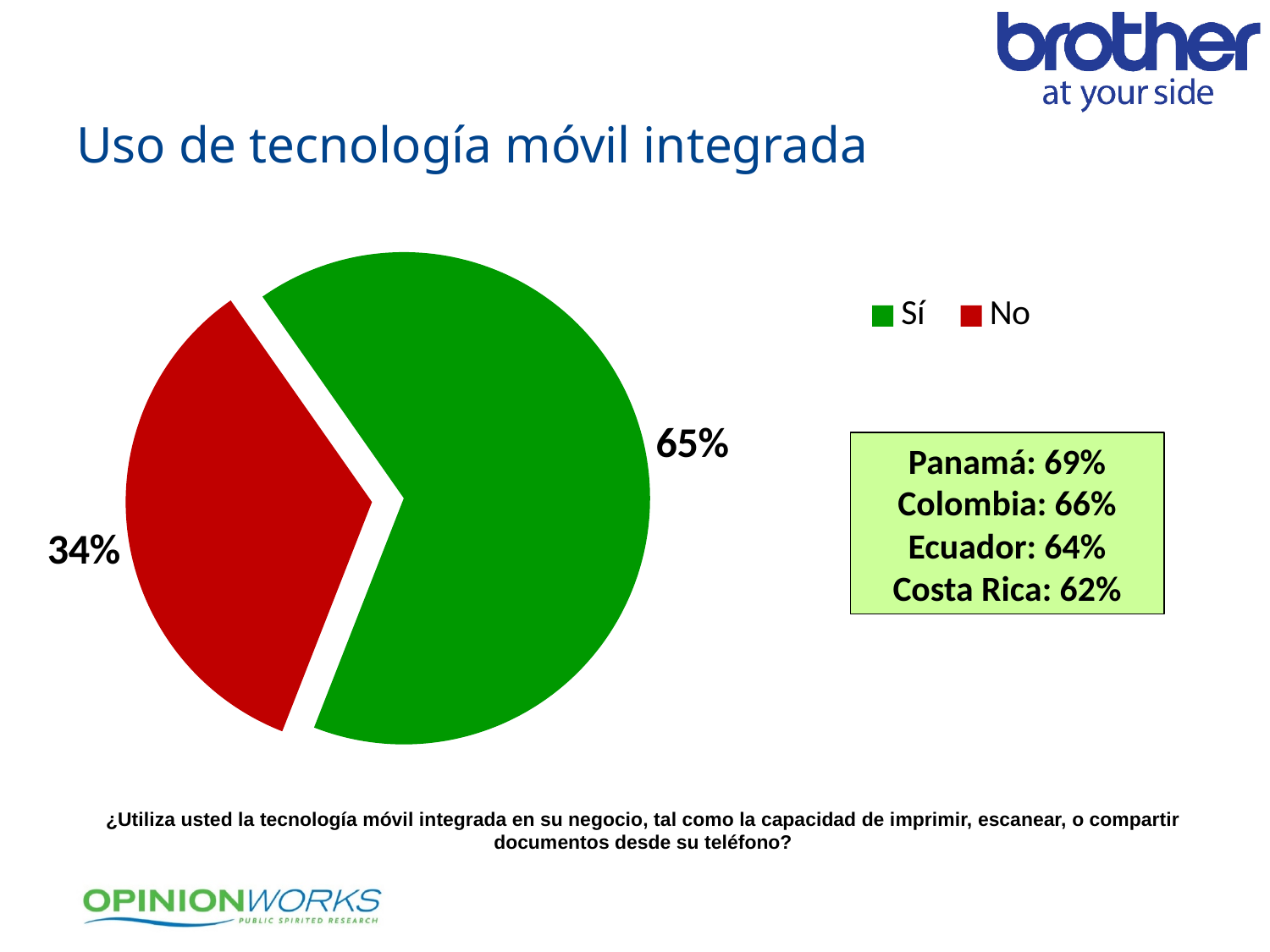
Which is larger, the "Sí" slice or the "No" slice? Sí How many slices does the pie chart have? 2 How many entries does the legend list? 2 What is the difference in percentage points between the "Sí" and "No" slices? 31 What kind of chart is shown on the slide? pie chart Which slice of the pie is the largest? Sí What share of the pie does the "Sí" slice represent? 65% What colour is the "Sí" slice? green What percentage of respondents answered "Sí"? 65% What colour is the "No" slice? red What percentage of respondents answered "No"? 34% Which slice of the pie is the smallest? No